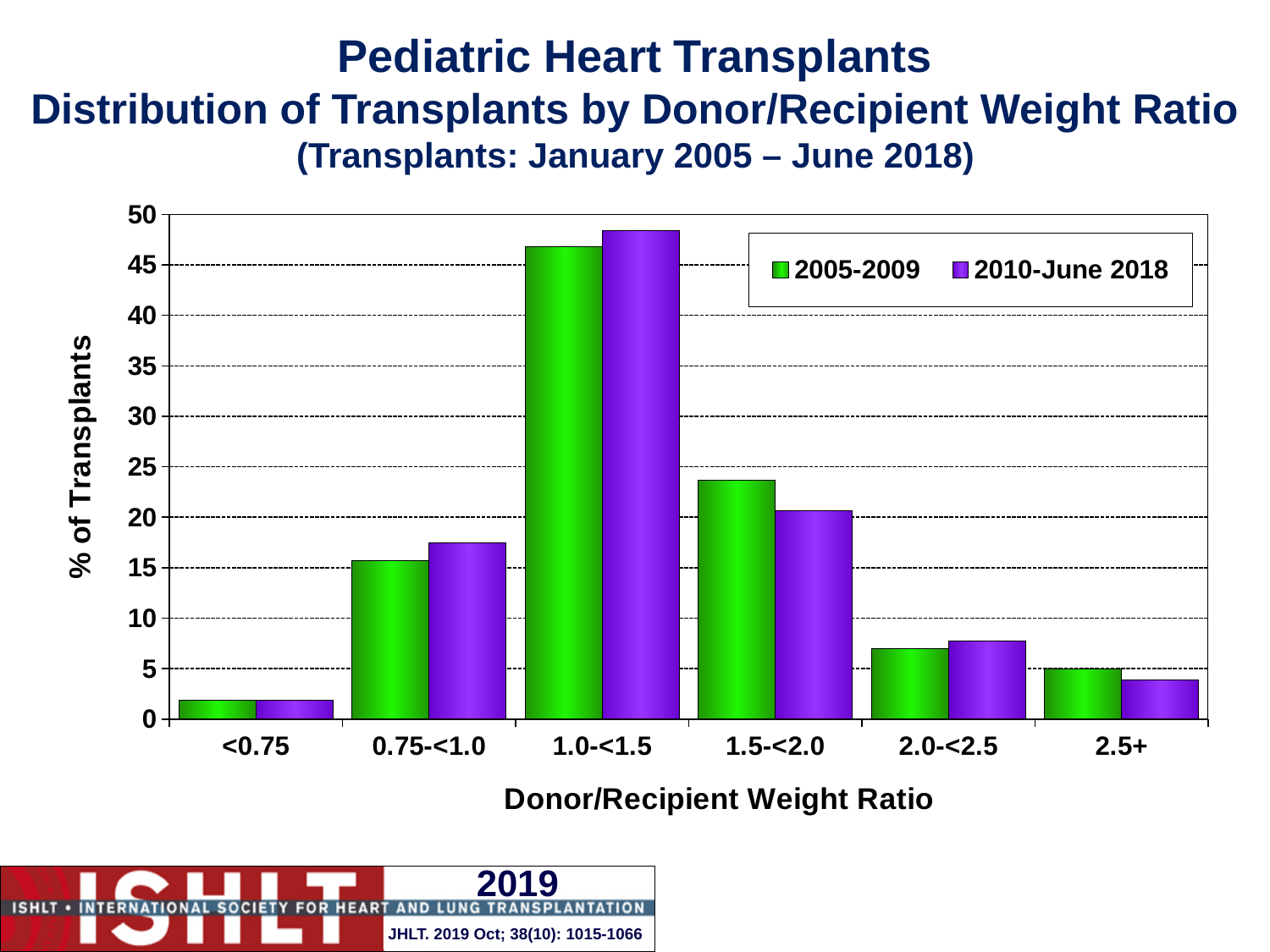
Is the value for 2005-2009 in the 1.5-<2.0 category greater or less than 20? greater Which weight ratio category has the highest value for the 2005-2009 series? 1.0-<1.5 What kind of chart is shown on the slide? bar chart Is the value for 2005-2009 in the 2.0-<2.5 category greater or less than 10? less How many series does the legend list? 2 For the 1.5-<2.0 category, which series has the larger value, 2005-2009 or 2010-June 2018? 2005-2009 Is the value for 2010-June 2018 in the 1.0-<1.5 category greater or less than 45? greater Which weight ratio category has the highest value for the 2010-June 2018 series? 1.0-<1.5 For the 0.75-<1.0 category, which series has the larger value, 2005-2009 or 2010-June 2018? 2010-June 2018 How many donor/recipient weight ratio categories are shown on the x axis? 6 Which weight ratio category has the lowest value for the 2010-June 2018 series? <0.75 What is the label of the y axis? % of Transplants